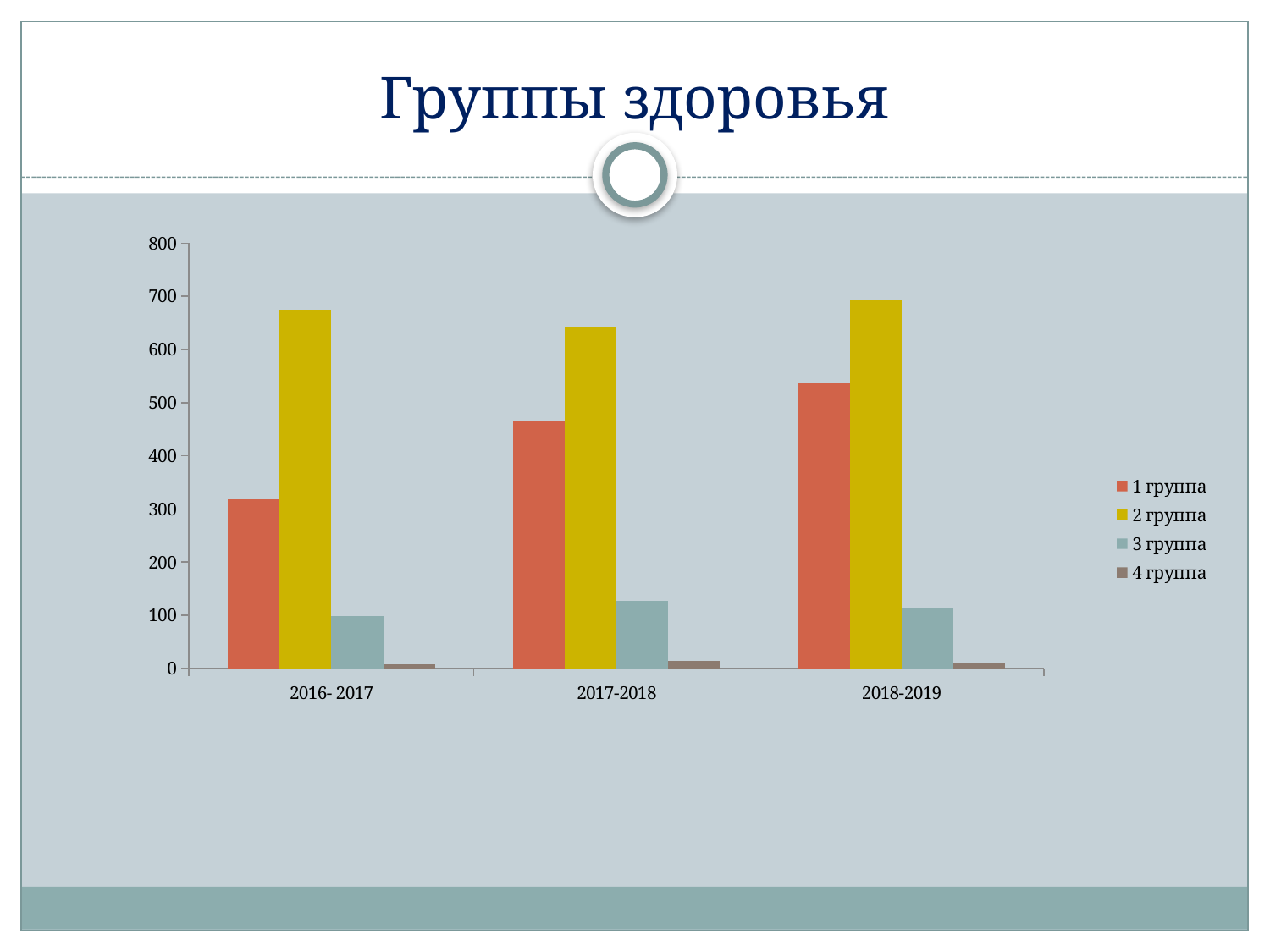
What kind of chart is shown on the slide? bar chart How many series does the legend list? 4 Is the value for 1 группа in 2018-2019 greater or less than 500? greater Which series has the lowest value in 2016- 2017? 4 группа Which is larger: 1 группа in 2017-2018 or 1 группа in 2018-2019? 1 группа in 2018-2019 How many categories are shown on the x axis? 3 What is the title of the chart? Группы здоровья Is the value for 1 группа in 2016- 2017 greater or less than 400? less Do the values for 1 группа rise or fall from 2016- 2017 to 2018-2019? rise Which series has the highest value in 2018-2019? 2 группа Is the value for 3 группа in 2017-2018 greater or less than 100? greater